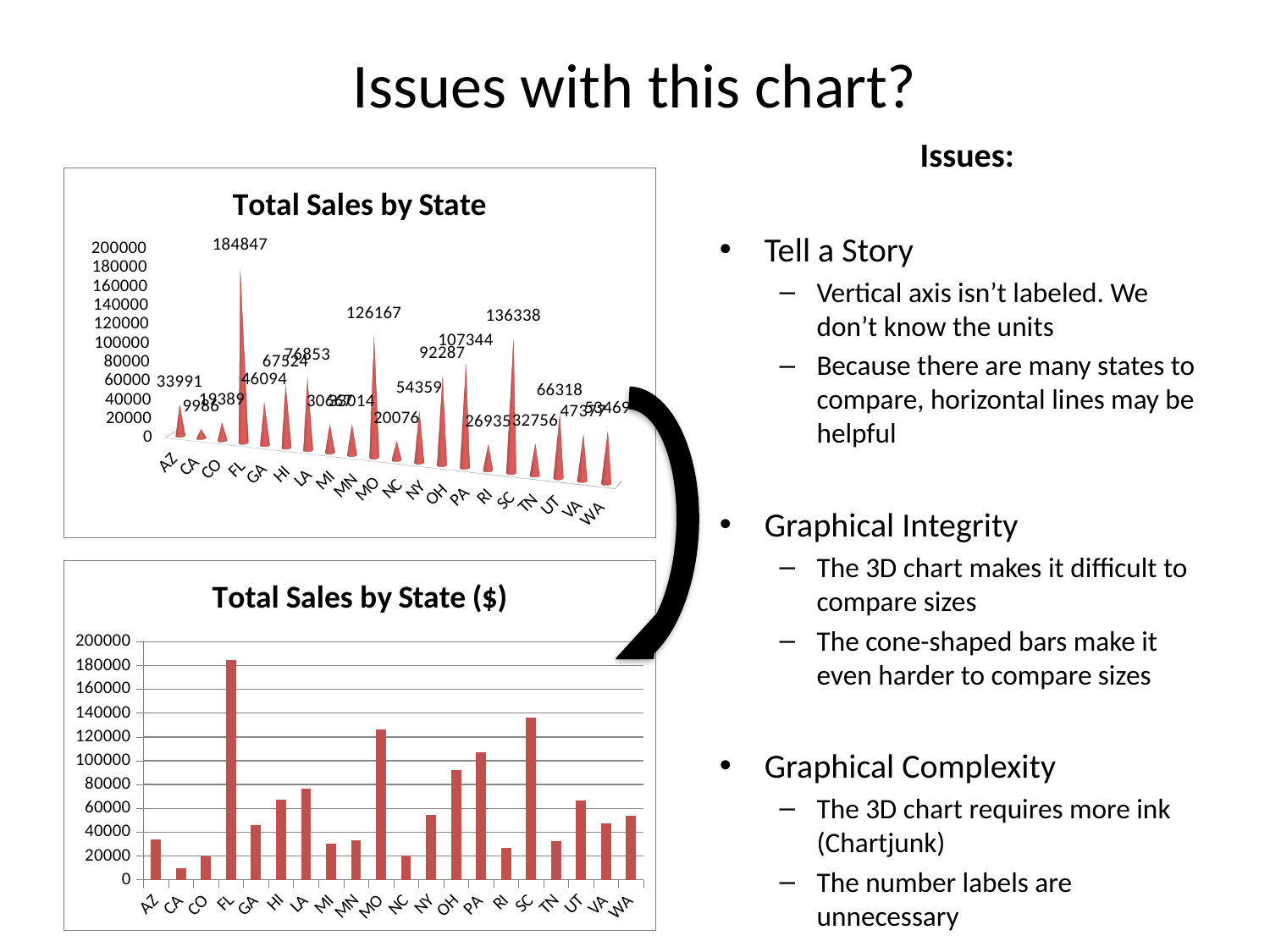
In the top chart, Total Sales by State, which state has the lowest total sales? CA In the top chart, Total Sales by State, what is the value for SC? 136338 In the bottom chart, Total Sales by State ($), is the value for CA greater or less than 20000? less In the top chart, Total Sales by State, which state has the highest total sales? FL In the bottom chart, Total Sales by State ($), is the value for FL greater or less than 160000? greater In the top chart, Total Sales by State, what is the difference between the values for FL and SC? 48509 In the top chart, Total Sales by State, what is the value for MO? 126167 What kind of chart is the bottom chart, Total Sales by State ($)? bar chart What is the title of the bottom chart? Total Sales by State ($) How many states are shown in the top chart, Total Sales by State? 20 In the top chart, Total Sales by State, what is the value for FL? 184847 In the top chart, Total Sales by State, which is larger, the value for OH or the value for PA? PA